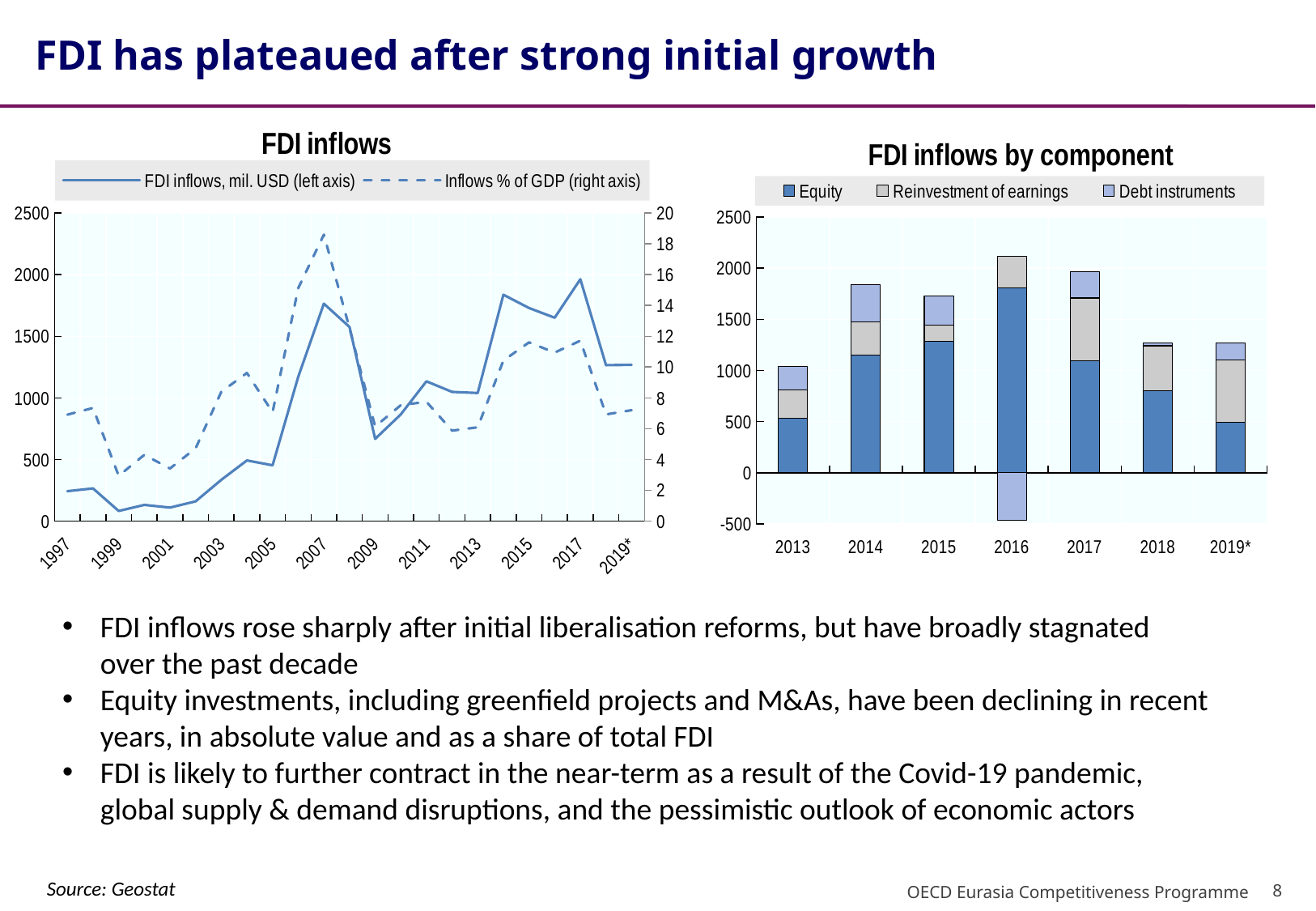
In the 'FDI inflows by component' chart, is the Equity value larger in 2016 or in 2017? 2016 What kind of chart is the 'FDI inflows by component' chart on the right? stacked bar chart In the 'FDI inflows' chart, is the value for FDI inflows, mil. USD in 2007 greater or less than 1500? greater In the 'FDI inflows' chart, is the value for FDI inflows, mil. USD in 2009 greater or less than 1000? less How many series does the legend of the 'FDI inflows' chart list? 2 How many years are shown on the x axis of the 'FDI inflows by component' chart? 7 In the 'FDI inflows by component' chart, which year has the highest Equity value? 2016 What kind of chart is the 'FDI inflows' chart on the left? line chart How many series does the legend of the 'FDI inflows by component' chart list? 3 In the 'FDI inflows by component' chart, is the Equity value for 2018 greater or less than 1000? less In the 'FDI inflows' chart, which year has the highest value for FDI inflows, mil. USD? 2017